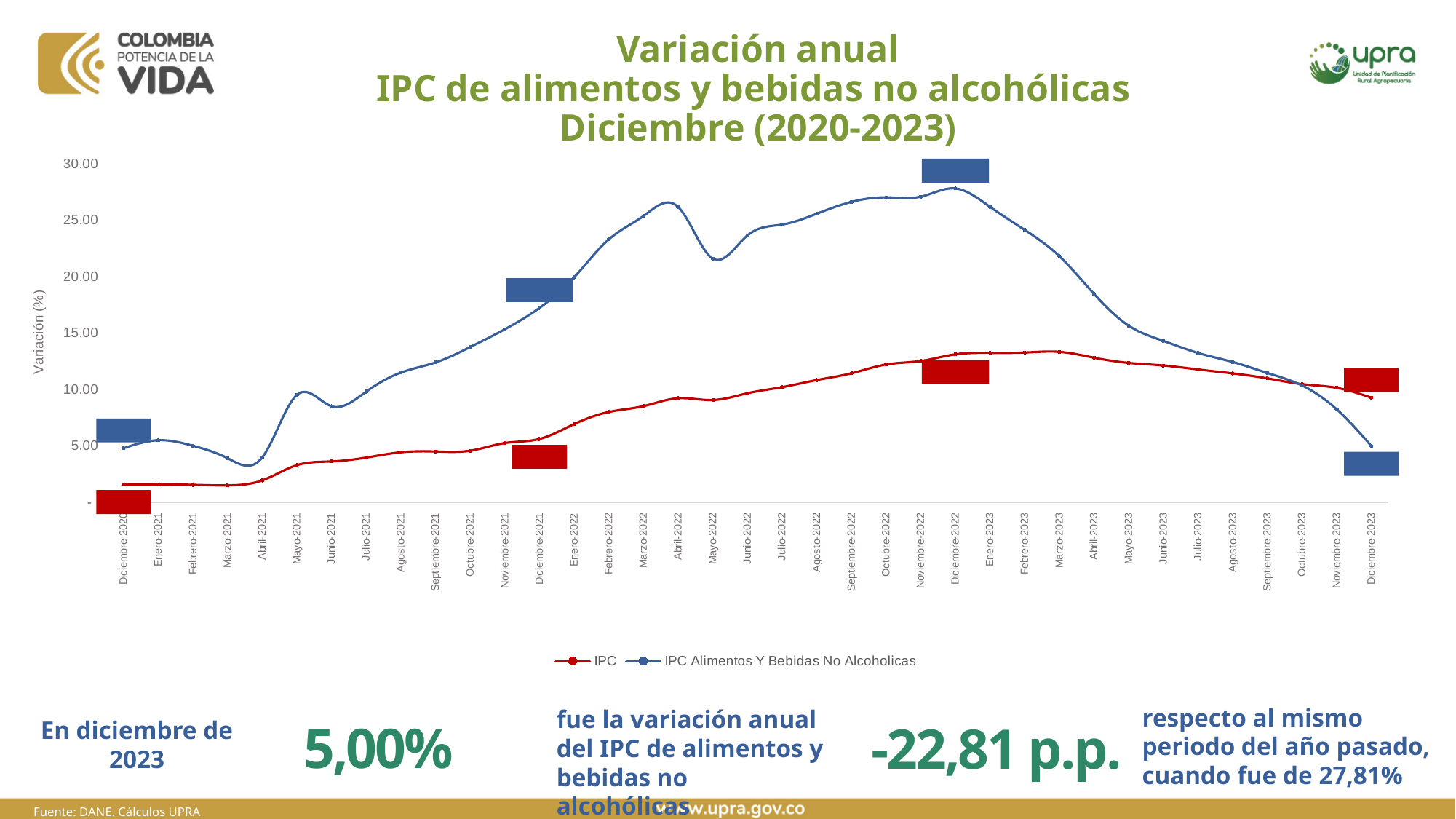
What was the annual variation of the IPC de alimentos y bebidas no alcohólicas in Diciembre-2022? 27,81% What kind of chart is shown on the slide? Line chart In which month does the IPC Alimentos Y Bebidas No Alcoholicas series reach its highest value? Diciembre-2022 Does the IPC Alimentos Y Bebidas No Alcoholicas series rise or fall from Diciembre-2022 to Diciembre-2023? Fall How many monthly points are plotted along the x axis, from Diciembre-2020 to Diciembre-2023? 37 How many series does the legend list? 2 Is the value of the IPC series in Marzo-2023 greater or less than 10.00? greater By how many percentage points did the IPC de alimentos y bebidas no alcohólicas variation change between Diciembre-2022 and Diciembre-2023? -22,81 p.p. What was the annual variation of the IPC de alimentos y bebidas no alcohólicas in Diciembre-2023? 5,00% In Diciembre-2022, which series has the larger value, IPC or IPC Alimentos Y Bebidas No Alcoholicas? IPC Alimentos Y Bebidas No Alcoholicas Is the value of the IPC series in Diciembre-2020 greater or less than 5.00? less Is the value of the IPC Alimentos Y Bebidas No Alcoholicas series in Abril-2022 greater or less than 25.00? greater